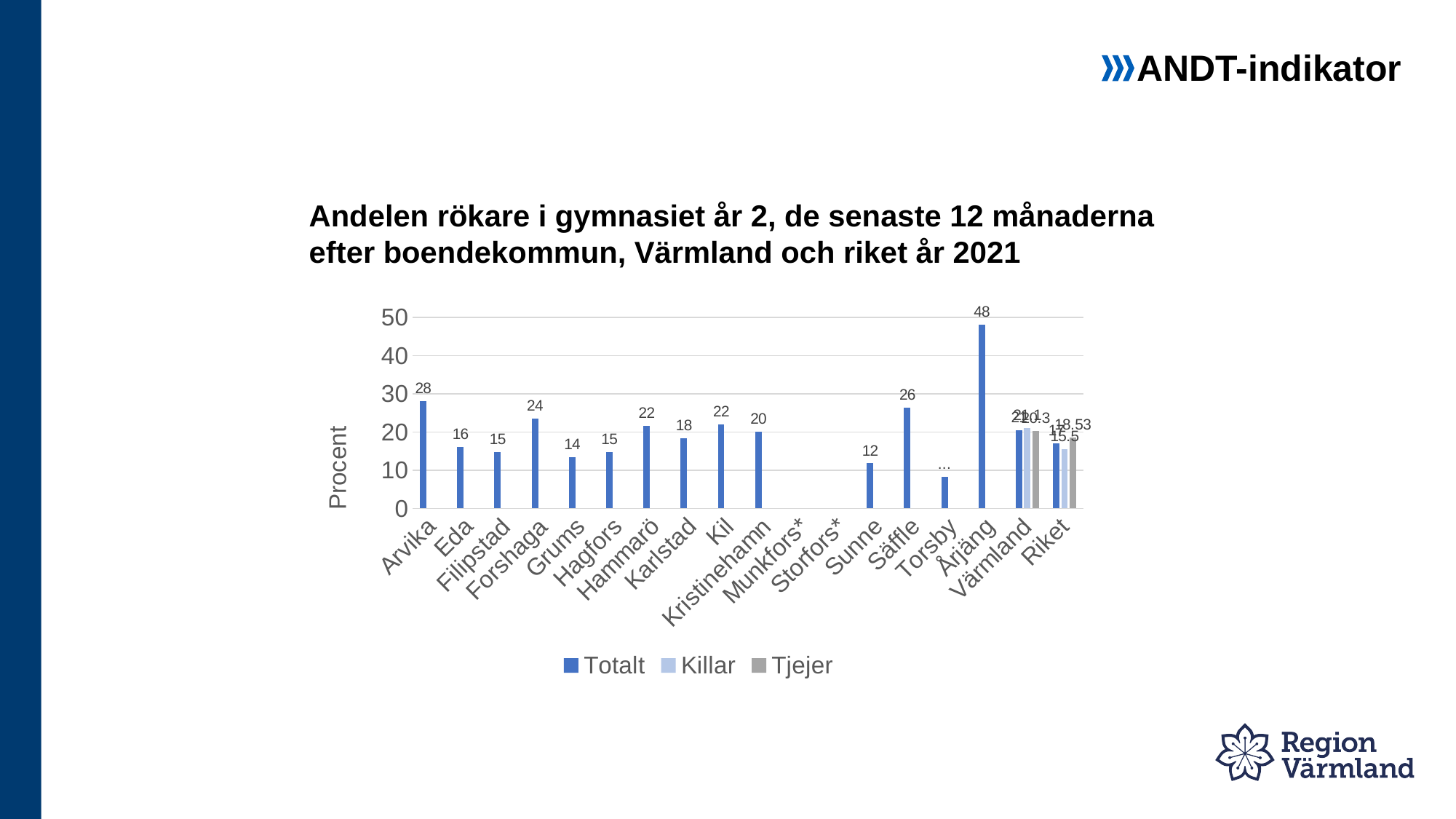
What is the label on the y axis? Procent What is the Totalt value for Säffle? 26 Which has a larger Totalt value, Forshaga or Säffle? Säffle How many series does the legend list? 3 What is the Totalt value for Kristinehamn? 20 What is the Totalt value for Arvika? 28 What is the Killar value for Riket? 15.5 How many categories are shown on the x axis? 18 What is the difference between the Totalt values for Arvika and Eda? 12 What kind of chart is shown on the slide? bar chart Which category has the highest Totalt value? Årjäng Is the Totalt value for Torsby greater or less than 10? less